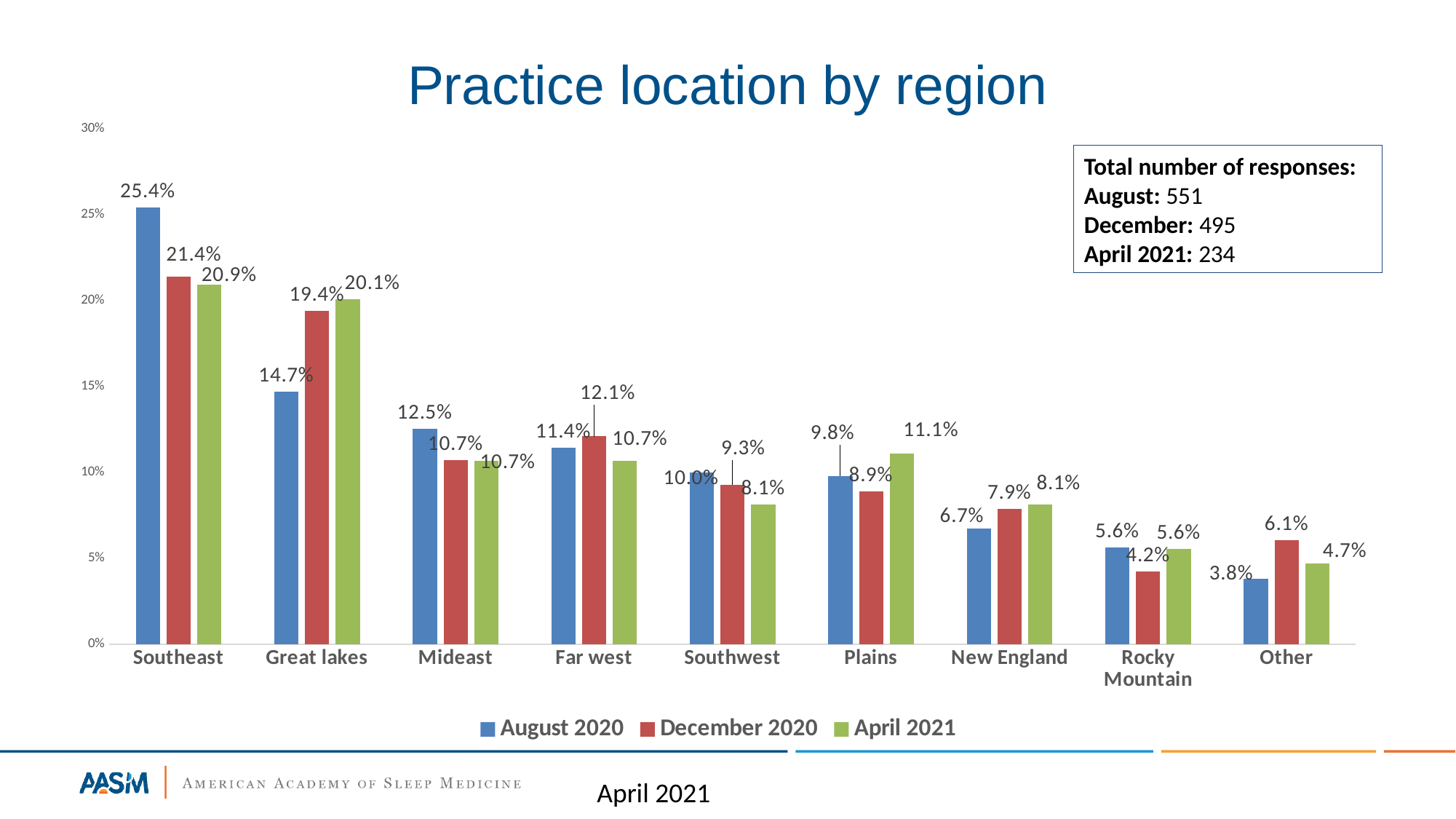
What is the total number of responses for December shown in the text box? 495 What is the value for Great lakes in the April 2021 series? 20.1% What kind of chart is shown on the slide? Bar chart Which region has the lowest value in the December 2020 series? Rocky Mountain What is the value for Southeast in the August 2020 series? 25.4% What is the value for Plains in the December 2020 series? 8.9% Which region has the highest value in the August 2020 series? Southeast How many series does the legend list? 3 How many regions are shown on the x axis? 9 What is the difference between the August 2020 and April 2021 values for Southeast? 4.5% Is the April 2021 value for Plains greater or less than 10%? greater Which is larger for Great lakes: the August 2020 value or the December 2020 value? December 2020